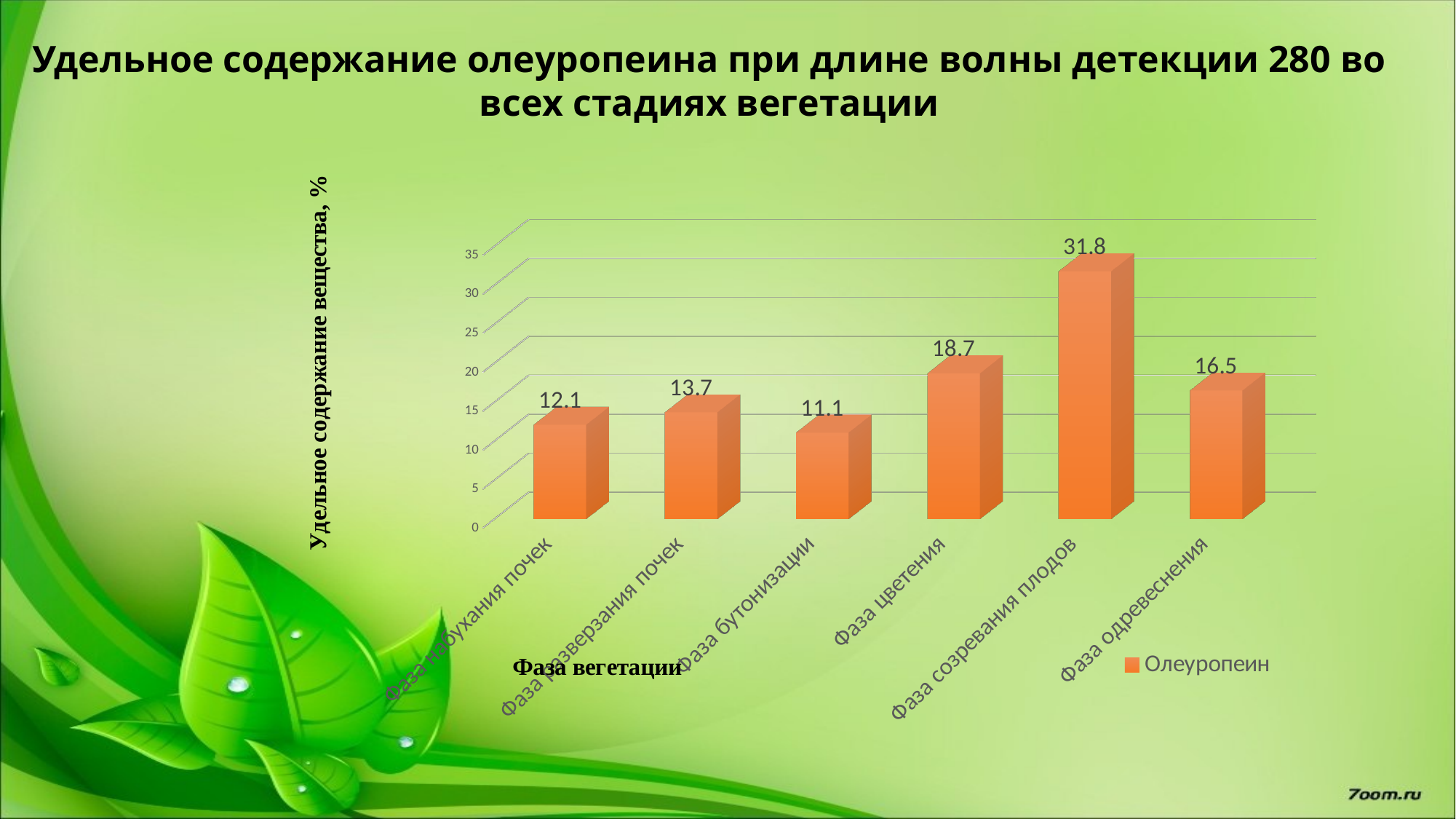
What is the difference between the values for Фаза разверзания почек and Фаза набухания почек? 1.6 Which is larger, the value for Фаза одревеснения or the value for Фаза разверзания почек? Фаза одревеснения What is the difference between the values for Фаза созревания плодов and Фаза цветения? 13.1 What kind of chart is shown on the slide? Bar chart How many vegetation phases are shown on the x axis? 6 Which phase has the highest oleuropein content? Фаза созревания плодов What is the value for Фаза цветения? 18.7 What is the value for Фаза одревеснения? 16.5 How many series does the legend list? 1 Which phase has the lowest oleuropein content? Фаза бутонизации What is the label of the y axis? Удельное содержание вещества, % What is the value for Фаза бутонизации? 11.1